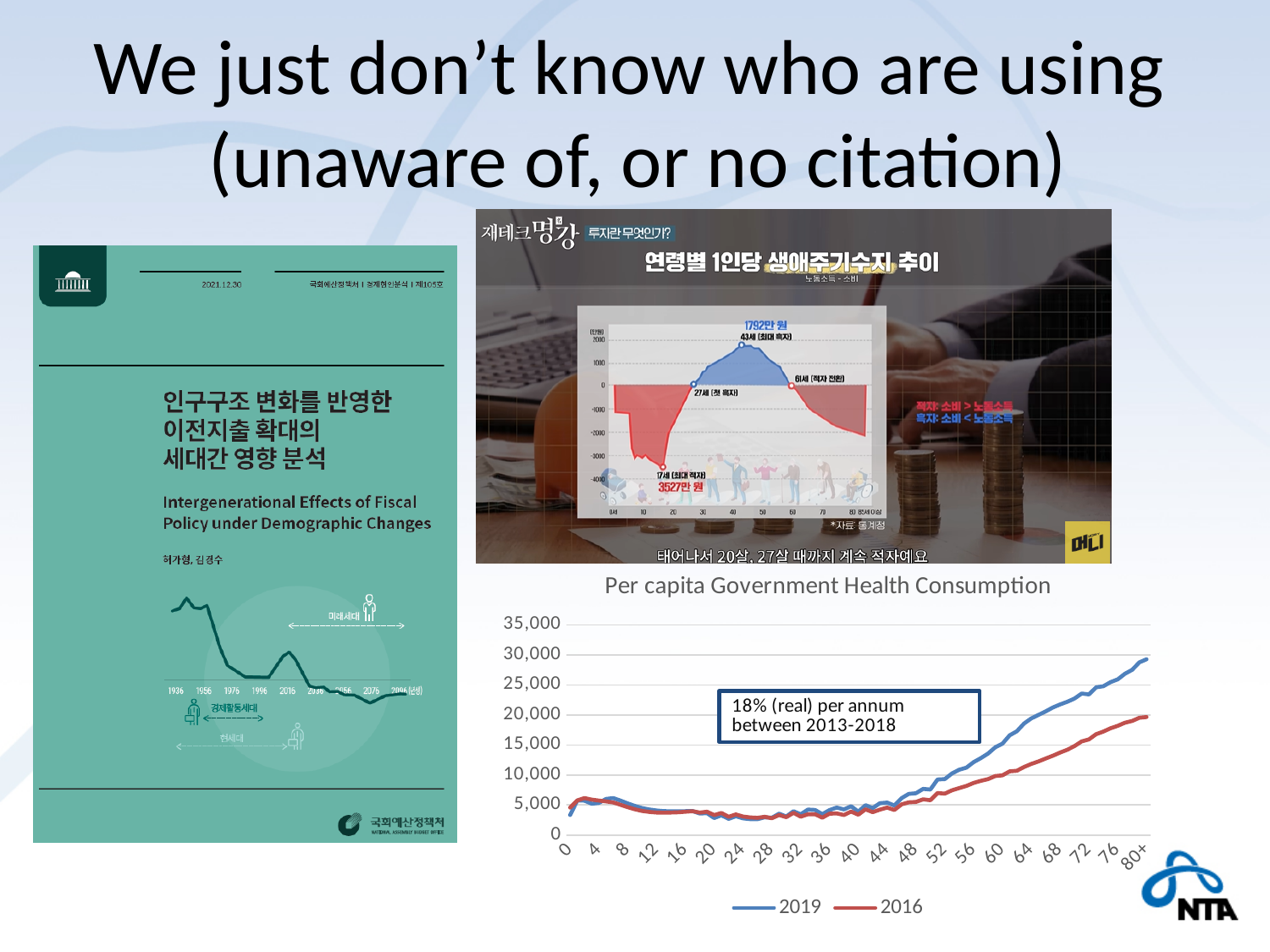
In the 'Per capita Government Health Consumption' chart, do the values generally rise or fall as age increases from 20 to 80+? rise In the 'Per capita Government Health Consumption' chart, at which age label does the 2019 series reach its highest value? 80+ In the 'Per capita Government Health Consumption' chart, which series is higher at age 60, 2019 or 2016? 2019 In the 'Per capita Government Health Consumption' chart, is the 2019 value at age 80+ greater or less than 25,000? greater In the 'Per capita Government Health Consumption' chart, which colour is the 2016 line? red In the 'Per capita Government Health Consumption' chart, which series is higher at age 80+, 2019 or 2016? 2019 In the 'Per capita Government Health Consumption' chart, is the 2019 value at age 20 greater or less than 5,000? less What kind of chart is the 'Per capita Government Health Consumption' chart? line chart What are the two series named in the legend of the 'Per capita Government Health Consumption' chart? 2019 and 2016 In the 'Per capita Government Health Consumption' chart, is the 2016 value at age 80+ greater or less than 25,000? less How many series does the legend of the 'Per capita Government Health Consumption' chart list? 2 What is the highest tick value shown on the y axis of the 'Per capita Government Health Consumption' chart? 35,000